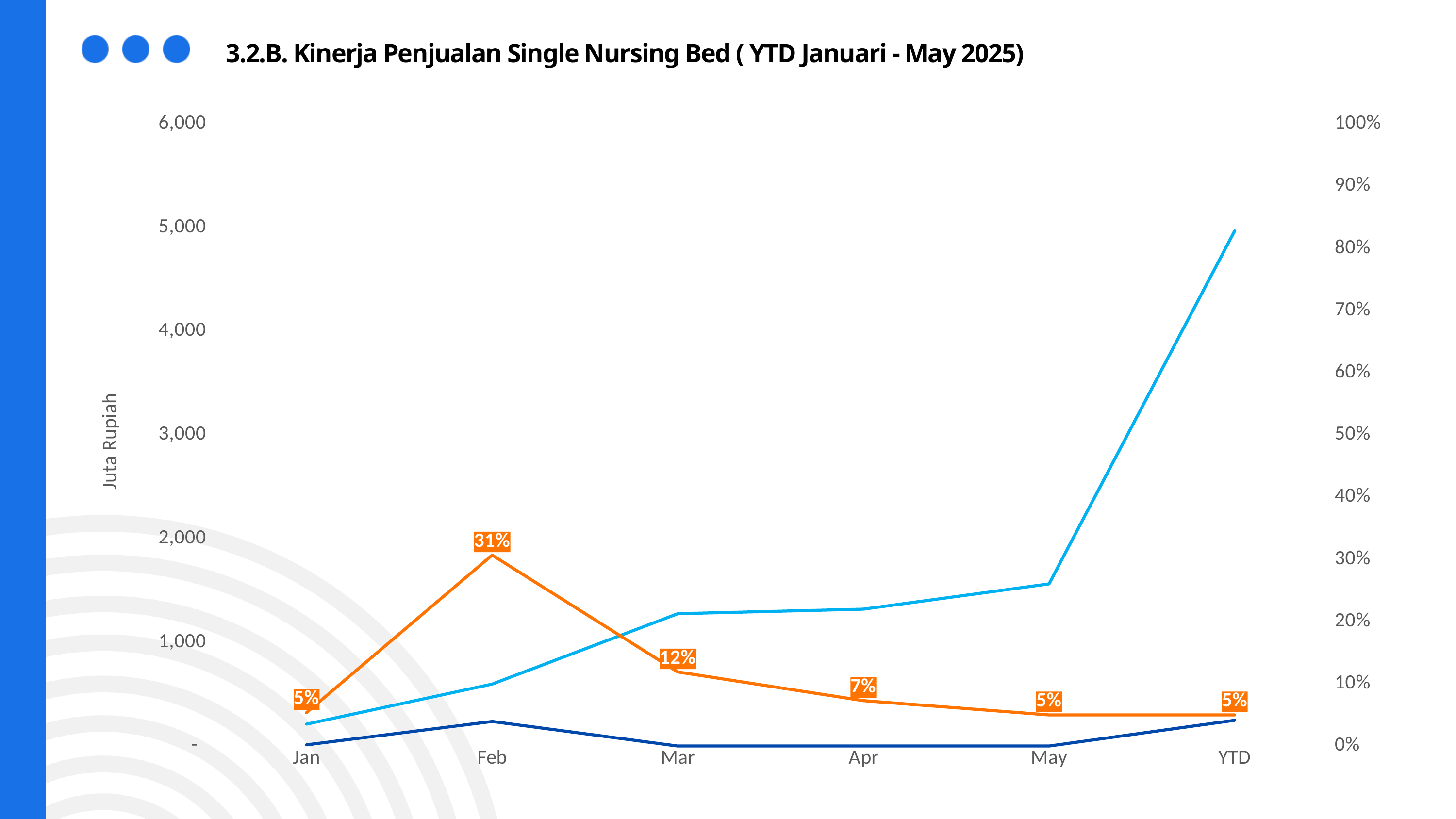
What is the percentage data label shown for Apr on the orange line? 7% How many categories are shown on the x axis? 6 What is the percentage data label shown for Mar on the orange line? 12% What is the percentage data label shown for Feb on the orange line? 31% Which has the larger labelled percentage on the orange line, Mar or Apr? Mar In which month does the orange percentage line reach its highest labelled value? Feb Does the light blue line rise or fall from Jan to YTD? rise What is the title of the left vertical axis? Juta Rupiah What is the percentage data label shown for YTD on the orange line? 5% What type of chart is shown on the slide? line chart Is the value of the light blue line at YTD greater or less than 4,000? greater What is the difference between the orange line's labelled values for Feb and Mar? 19%